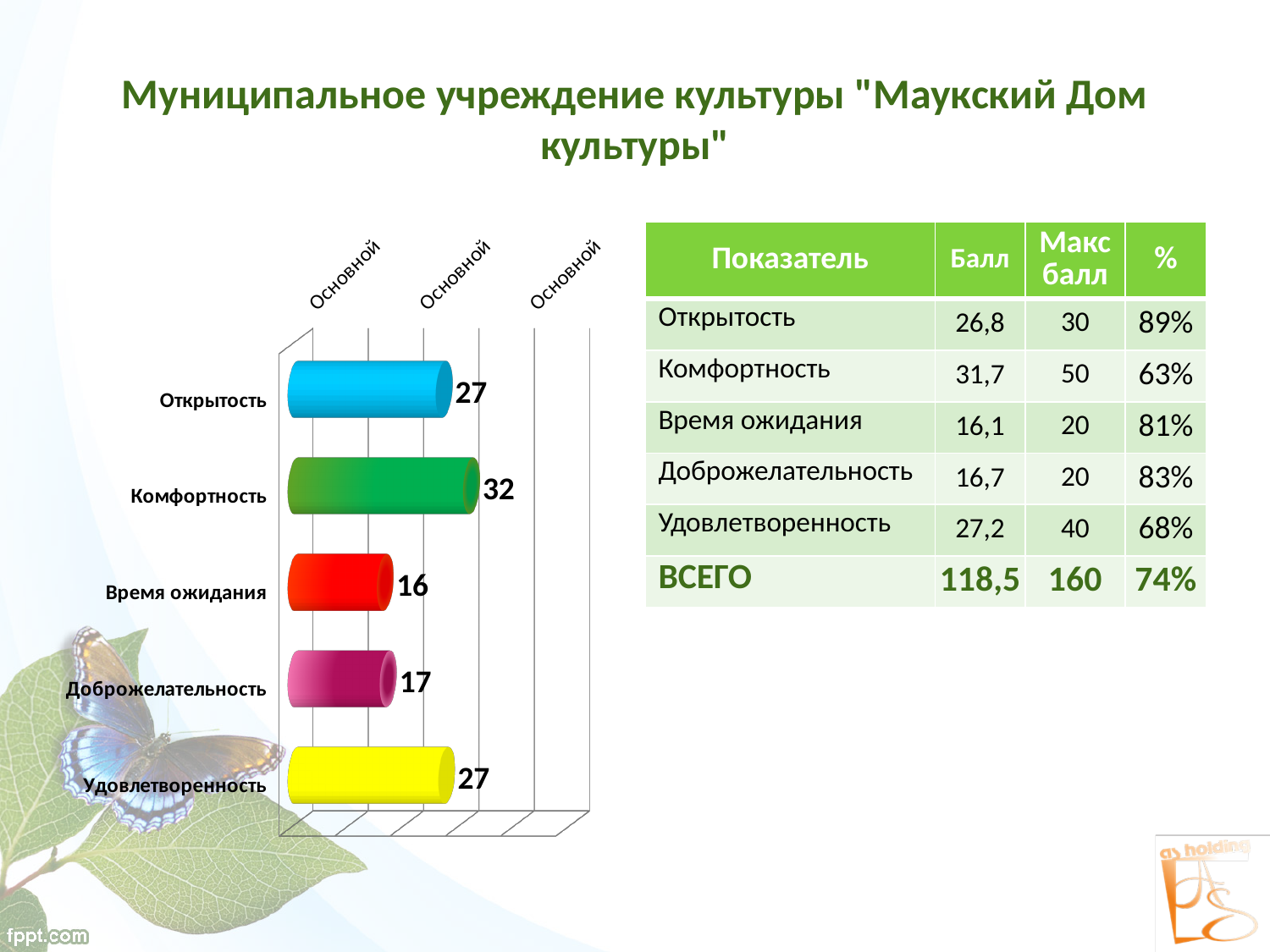
What is the value shown for Доброжелательность in the bar chart? 17 Which category has the lowest value in the bar chart? Время ожидания How many categories are shown in the bar chart? 5 What is the value shown for Комфортность in the bar chart? 32 What colour is the bar for Комфортность in the chart? Green What kind of chart is shown on the slide? Bar chart What is the difference between the values for Комфортность and Время ожидания in the bar chart? 16 What is the value shown for Время ожидания in the bar chart? 16 Which is larger in the bar chart, the value for Открытость or the value for Доброжелательность? Открытость What is the value shown for Открытость in the bar chart? 27 Which category has the highest value in the bar chart? Комфортность What is the difference between the values for Удовлетворенность and Доброжелательность in the bar chart? 10